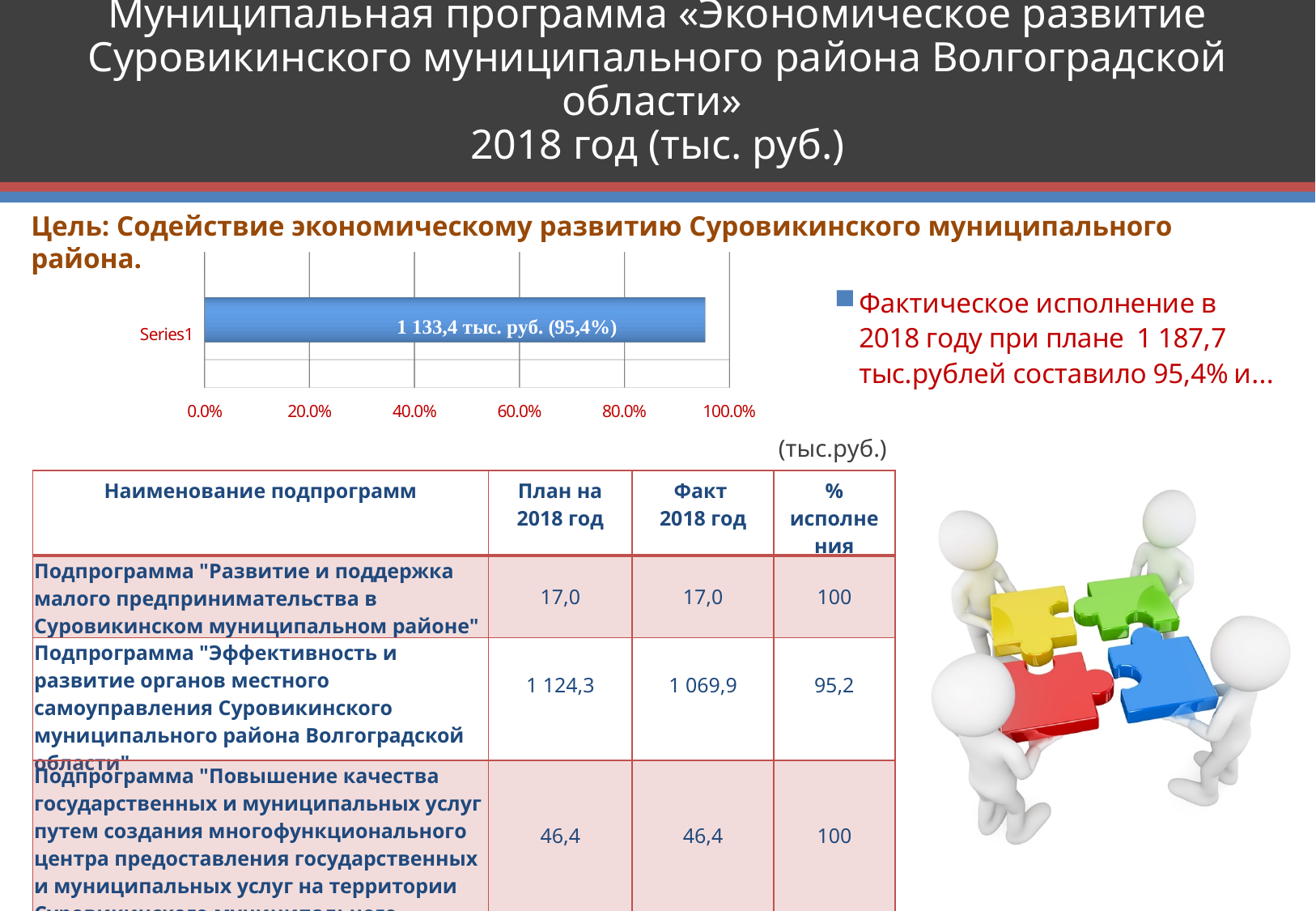
What is the data label printed on the bar for Series1? 1 133,4 тыс. руб. (95,4%) What kind of chart is shown on the slide? bar chart What is the label of the category shown on the vertical axis of the chart? Series1 Is the value for Series1 greater or less than 100.0%? less What is the highest tick value shown on the horizontal axis of the chart? 100.0% Is the value for Series1 greater or less than 80.0%? greater What percentage of execution is shown in the data label on the Series1 bar? 95,4% How many bars are plotted in the chart? 1